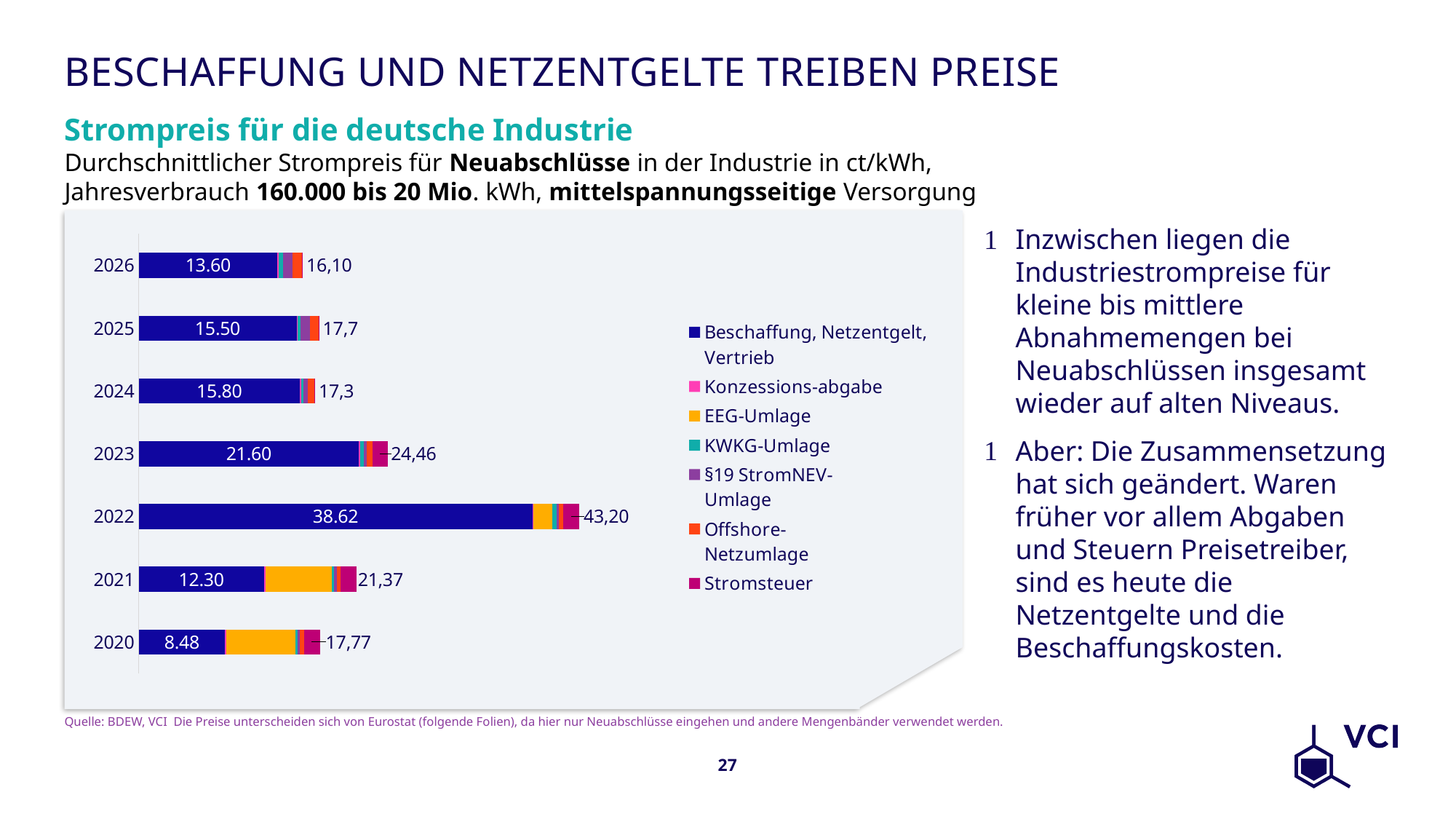
Is the total for 2023 larger or smaller than the total for 2021? larger What kind of chart is shown on the slide? stacked bar chart Which year has the highest total electricity price? 2022 What is the value of the Beschaffung, Netzentgelt, Vertrieb segment for 2022? 38.62 How many series does the legend list? 7 Which year has the lowest value for the Beschaffung, Netzentgelt, Vertrieb segment? 2020 What is the value of the Beschaffung, Netzentgelt, Vertrieb segment for 2021? 12.30 Which legend entry is shown in orange/yellow? EEG-Umlage How many years are shown on the chart? 7 What is the total electricity price shown for 2020? 17,77 What is the total electricity price shown for 2026? 16,10 What is the difference between the Beschaffung, Netzentgelt, Vertrieb values for 2024 and 2025? 0.30